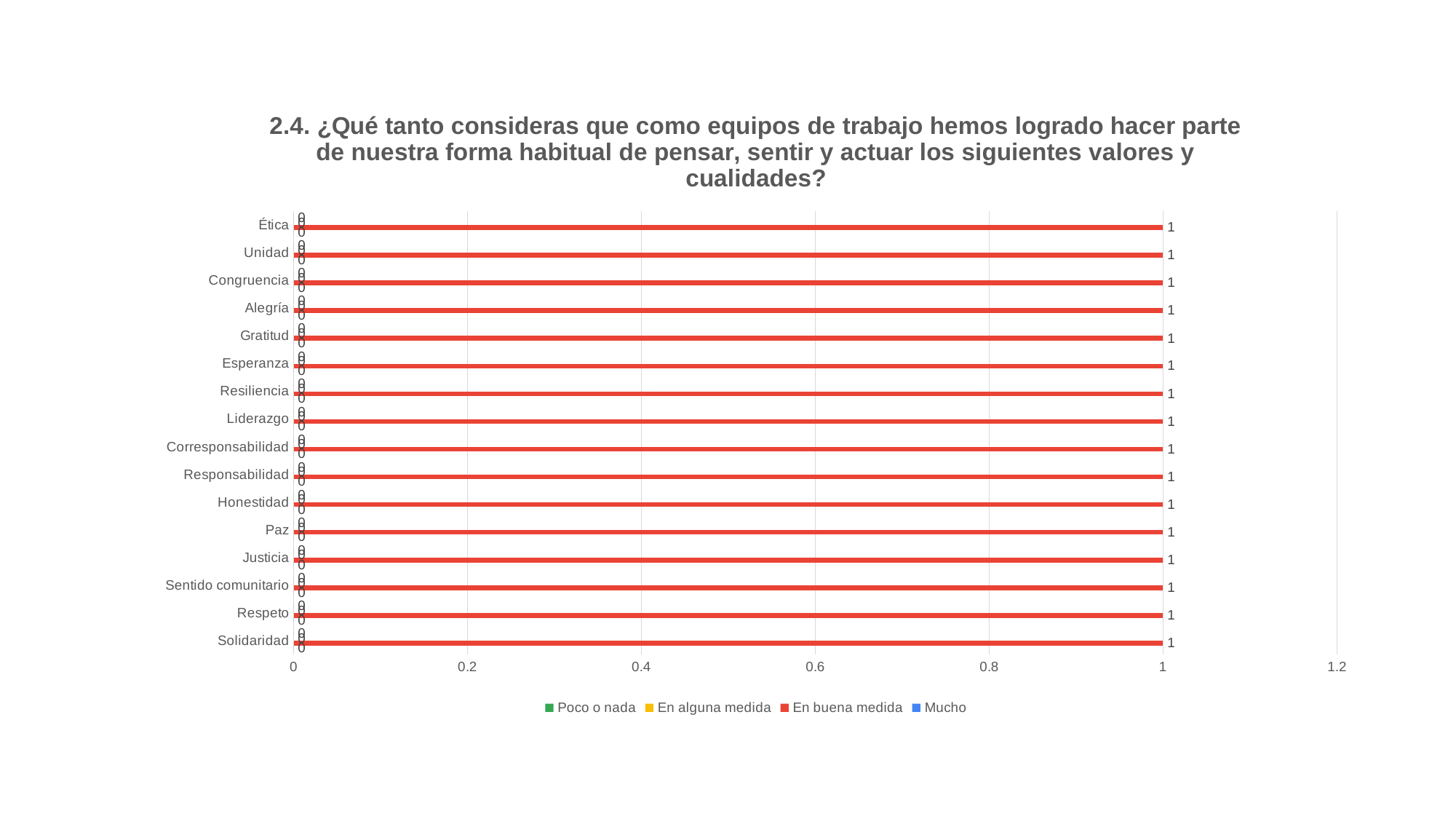
Which series has the highest value for Justicia? En buena medida How many categories (values and qualities) are listed on the vertical axis? 16 What is the value for 'En buena medida' for Ética? 1 What kind of chart is shown on the slide? bar chart What is the difference between the 'En buena medida' value and the 'Mucho' value for Paz? 1 Which legend entry is shown in red? En buena medida What is the value for 'Poco o nada' for Liderazgo? 0 How many series does the legend list? 4 Is the 'En buena medida' value for Gratitud larger than the 'En alguna medida' value for Gratitud? Yes What is the highest tick value shown on the horizontal axis? 1.2 What is the value for 'Mucho' for Respeto? 0 What is the value for 'En buena medida' for Solidaridad? 1